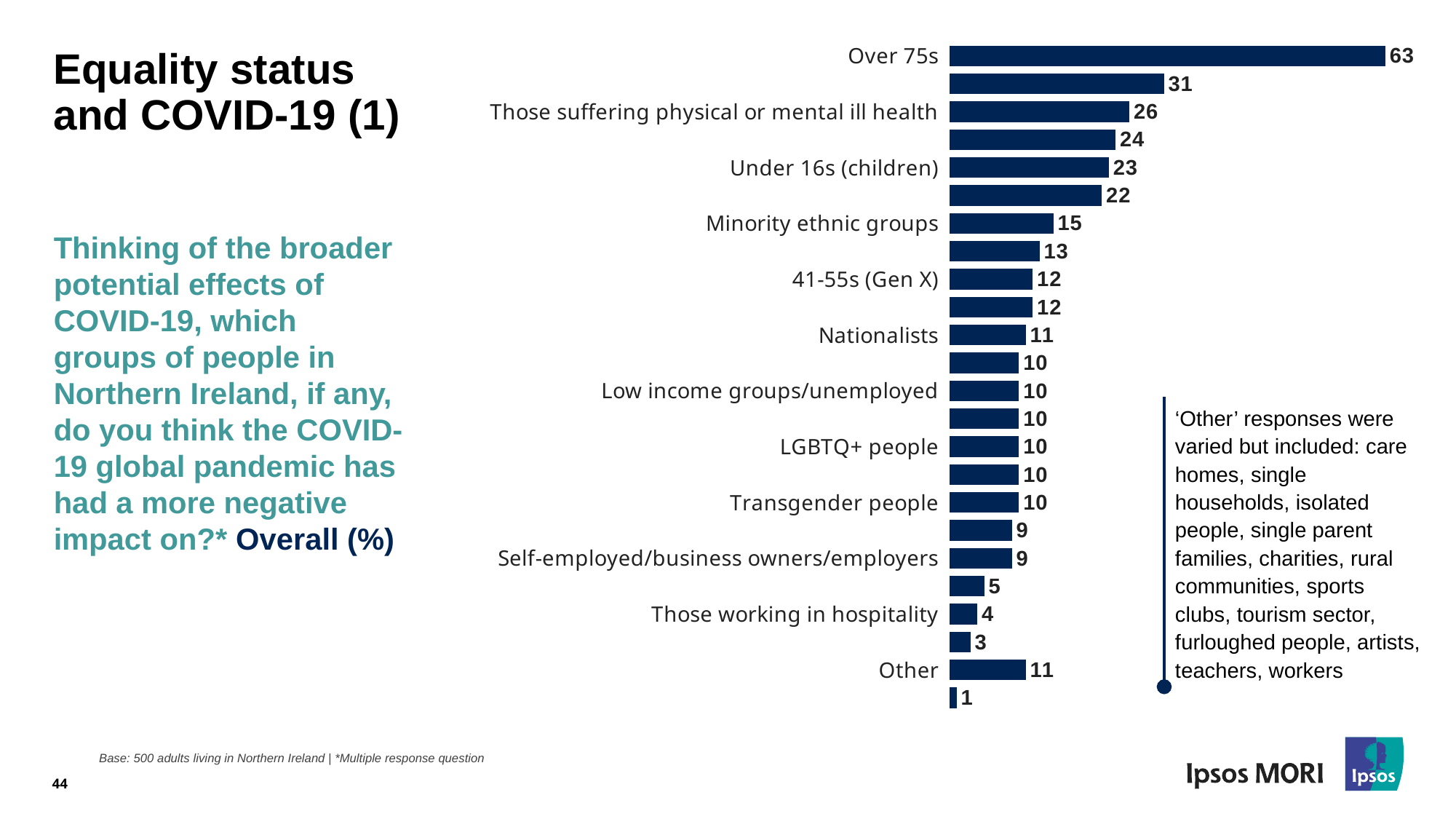
What kind of chart is shown on the slide? Bar chart What is the value shown for the Other category? 11 What is the value shown for Minority ethnic groups? 15 What is the difference between the values for Over 75s and Under 16s (children)? 40 What is the value shown for Those working in hospitality? 4 What is the value shown for Those suffering physical or mental ill health? 26 Which labelled group has the highest value in the chart? Over 75s What percentage of respondents said the pandemic had a more negative impact on Over 75s? 63 What is the value shown for Under 16s (children)? 23 Which has the larger value: Nationalists or Those working in hospitality? Nationalists What is the difference between the values for Minority ethnic groups and 41-55s (Gen X)? 3 According to the base note, how many adults living in Northern Ireland were surveyed? 500